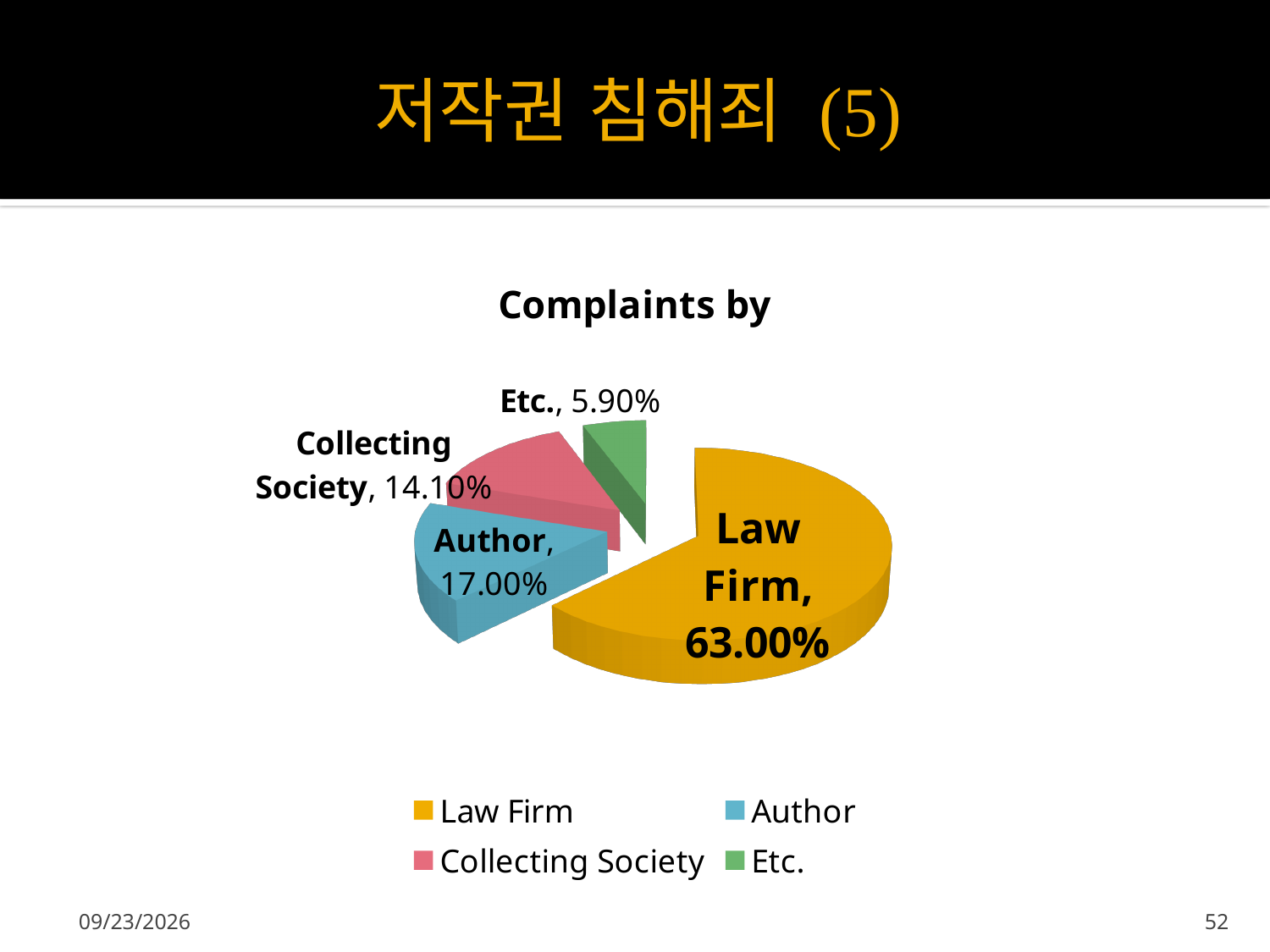
What is the difference in percentage points between the Law Firm share and the Author share? 46.00% What share of complaints is attributed to Law Firm? 63.00% Which category has the largest share of complaints? Law Firm How many entries does the legend list? 4 Which has a larger share of complaints, Author or Collecting Society? Author Which category has the smallest share of complaints? Etc. What share of complaints is attributed to Etc.? 5.90% What share of complaints is attributed to Author? 17.00% What is the title of the chart? Complaints by What share of complaints is attributed to Collecting Society? 14.10% How many slices does the pie chart have? 4 What kind of chart is shown on the slide? pie chart